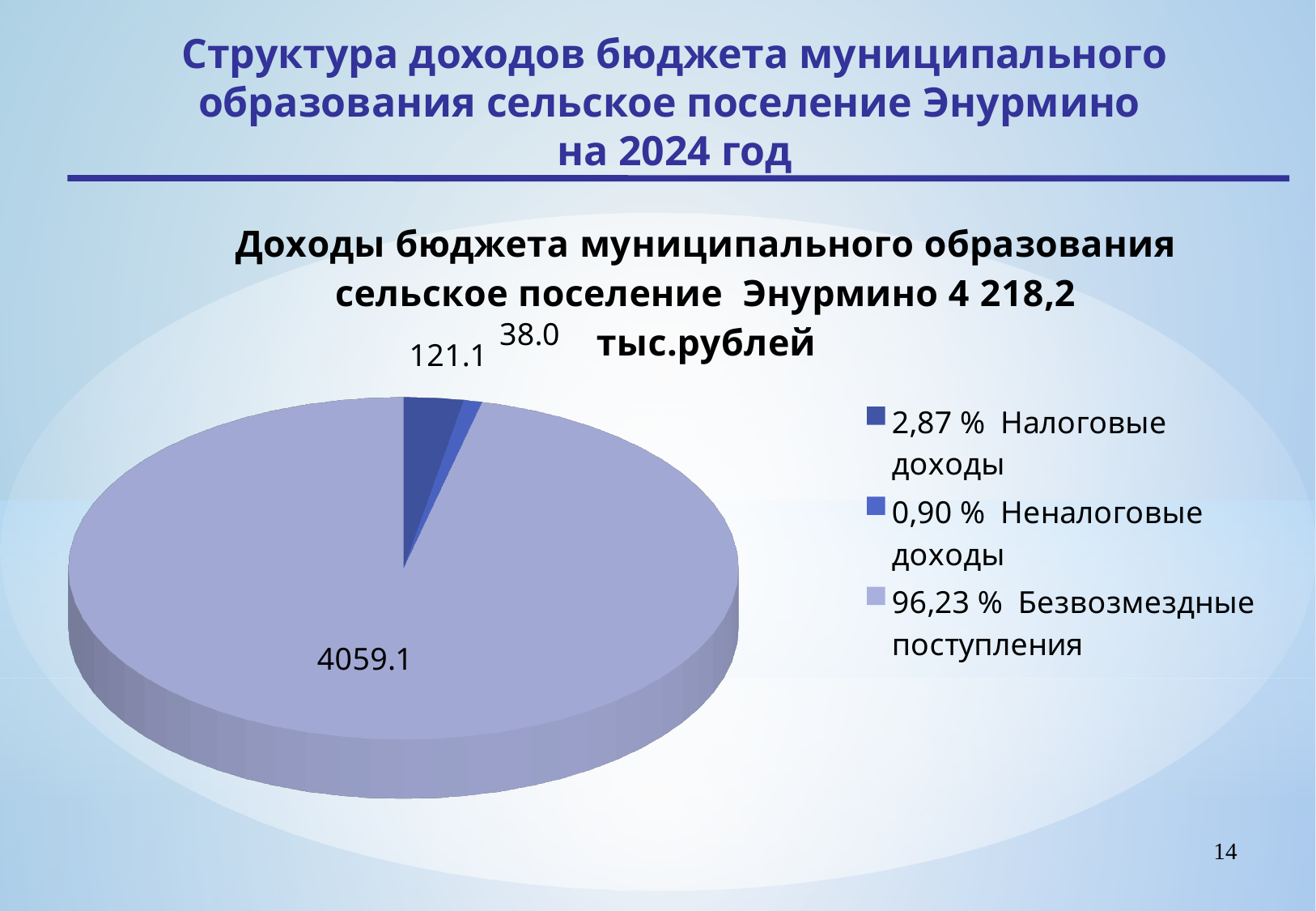
What kind of chart is shown on the slide? pie chart What is the value of the Налоговые доходы slice? 121.1 Which is larger: Налоговые доходы or Неналоговые доходы? Налоговые доходы What is the difference between the Налоговые доходы and Неналоговые доходы values? 83.1 Which category has the largest slice of the pie? Безвозмездные поступления Which category has the smallest slice of the pie? Неналоговые доходы What is the value of the Безвозмездные поступления slice? 4059.1 What share of the pie does Налоговые доходы represent, according to the legend? 2,87 % How many entries does the legend of the pie chart list? 3 How many slices does the pie chart have? 3 What is the value of the Неналоговые доходы slice? 38.0 What share of the pie does Безвозмездные поступления represent, according to the legend? 96,23 %